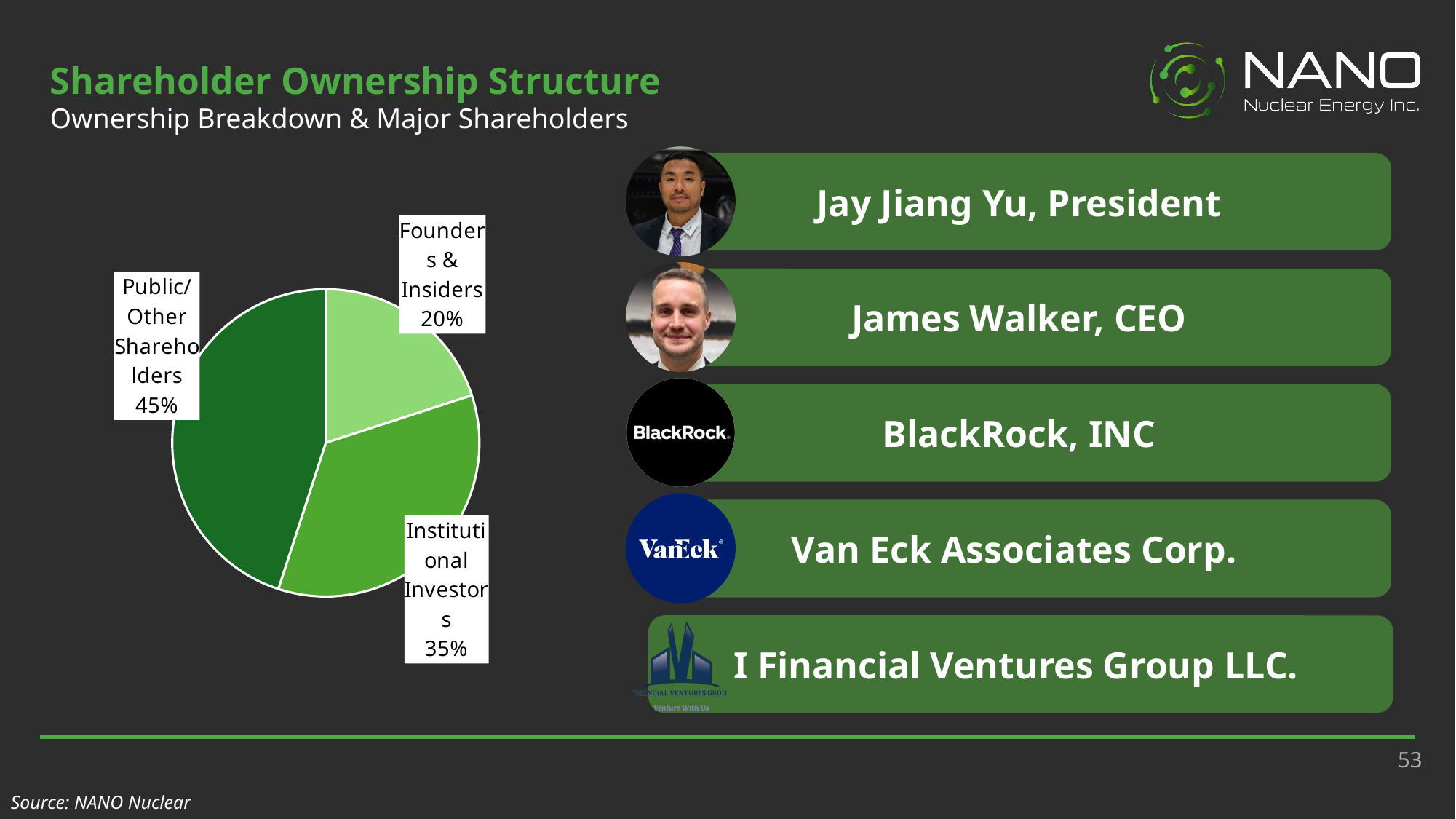
What is the difference in percentage points between the Public/Other Shareholders share and the Institutional Investors share? 10 What is the title of the slide containing the ownership pie chart? Shareholder Ownership Structure Which shareholder group holds the smallest share of ownership? Founders & Insiders What is the difference in percentage points between the Institutional Investors share and the Founders & Insiders share? 15 What share of ownership is held by Public/Other Shareholders? 45% How many shareholder groups are shown in the pie chart? 3 Which is larger, the share held by Institutional Investors or the share held by Founders & Insiders? Institutional Investors What is the combined share of Founders & Insiders and Institutional Investors? 55% Which shareholder group holds the largest share of ownership? Public/Other Shareholders What share of ownership is held by Founders & Insiders? 20% What share of ownership is held by Institutional Investors? 35% What kind of chart is used to show the ownership breakdown? Pie chart